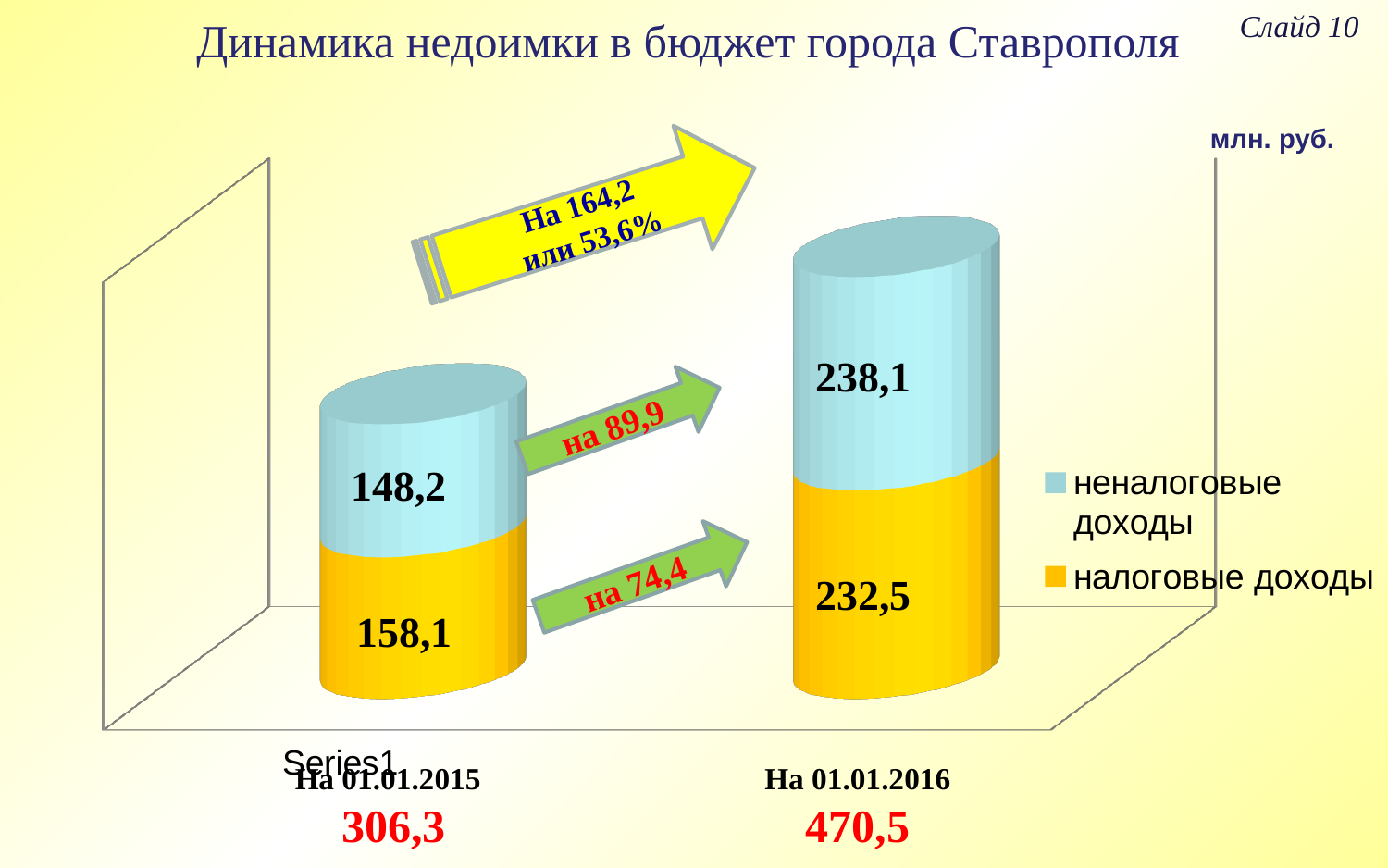
Which date has the larger total: На 01.01.2015 or На 01.01.2016? На 01.01.2016 What is the value of неналоговые доходы for На 01.01.2016? 238,1 By how much did неналоговые доходы increase from На 01.01.2015 to На 01.01.2016? 89,9 How many series does the legend list? 2 What is the value of налоговые доходы for На 01.01.2016? 232,5 What is the value of налоговые доходы for На 01.01.2015? 158,1 By how much did налоговые доходы increase from На 01.01.2015 to На 01.01.2016? 74,4 What is the title of the chart? Динамика недоимки в бюджет города Ставрополя What is the total of the stacked bar for На 01.01.2016? 470,5 What is the total of the stacked bar for На 01.01.2015? 306,3 What is the value of неналоговые доходы for На 01.01.2015? 148,2 What kind of chart is shown on the slide? Stacked bar chart